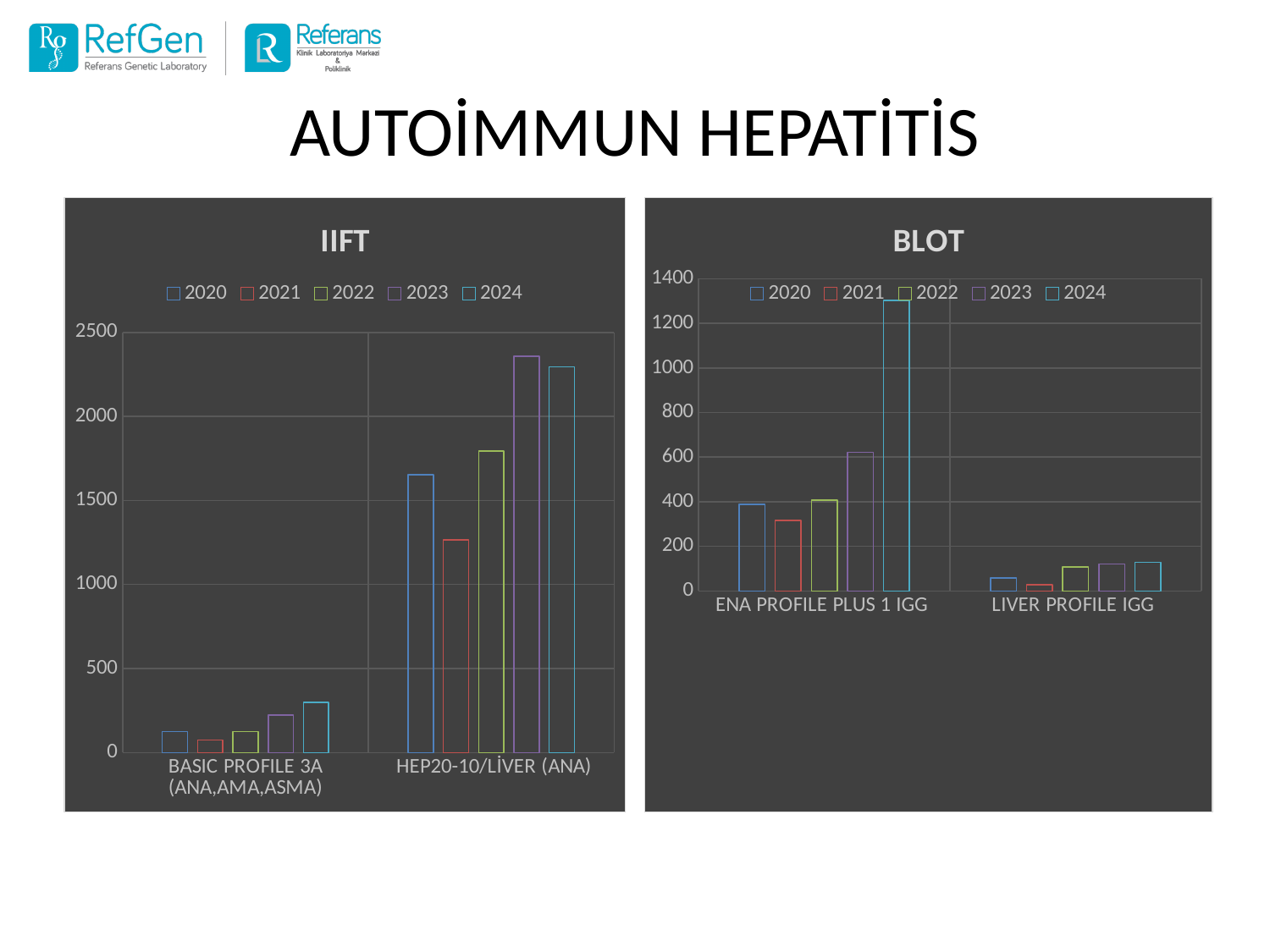
On the IIFT chart, what kind of chart is shown? bar chart On the IIFT chart, which year has the lowest value for BASIC PROFILE 3A (ANA,AMA,ASMA)? 2021 On the BLOT chart, is the 2023 value for ENA PROFILE PLUS 1 IGG greater or less than 800? less What is the title of the chart on the right side of the slide? BLOT On the BLOT chart, which year has the highest value for ENA PROFILE PLUS 1 IGG? 2024 On the BLOT chart, which is larger for LIVER PROFILE IGG: the 2021 value or the 2024 value? 2024 On the IIFT chart, is the 2023 value for HEP20-10/LİVER (ANA) greater or less than 2000? greater On the IIFT chart, is the 2021 value for HEP20-10/LİVER (ANA) greater or less than 1500? less On the IIFT chart, which year has the highest value for HEP20-10/LİVER (ANA)? 2023 On the BLOT chart, how many series does the legend list? 5 On the IIFT chart, how many categories are shown on the x axis? 2